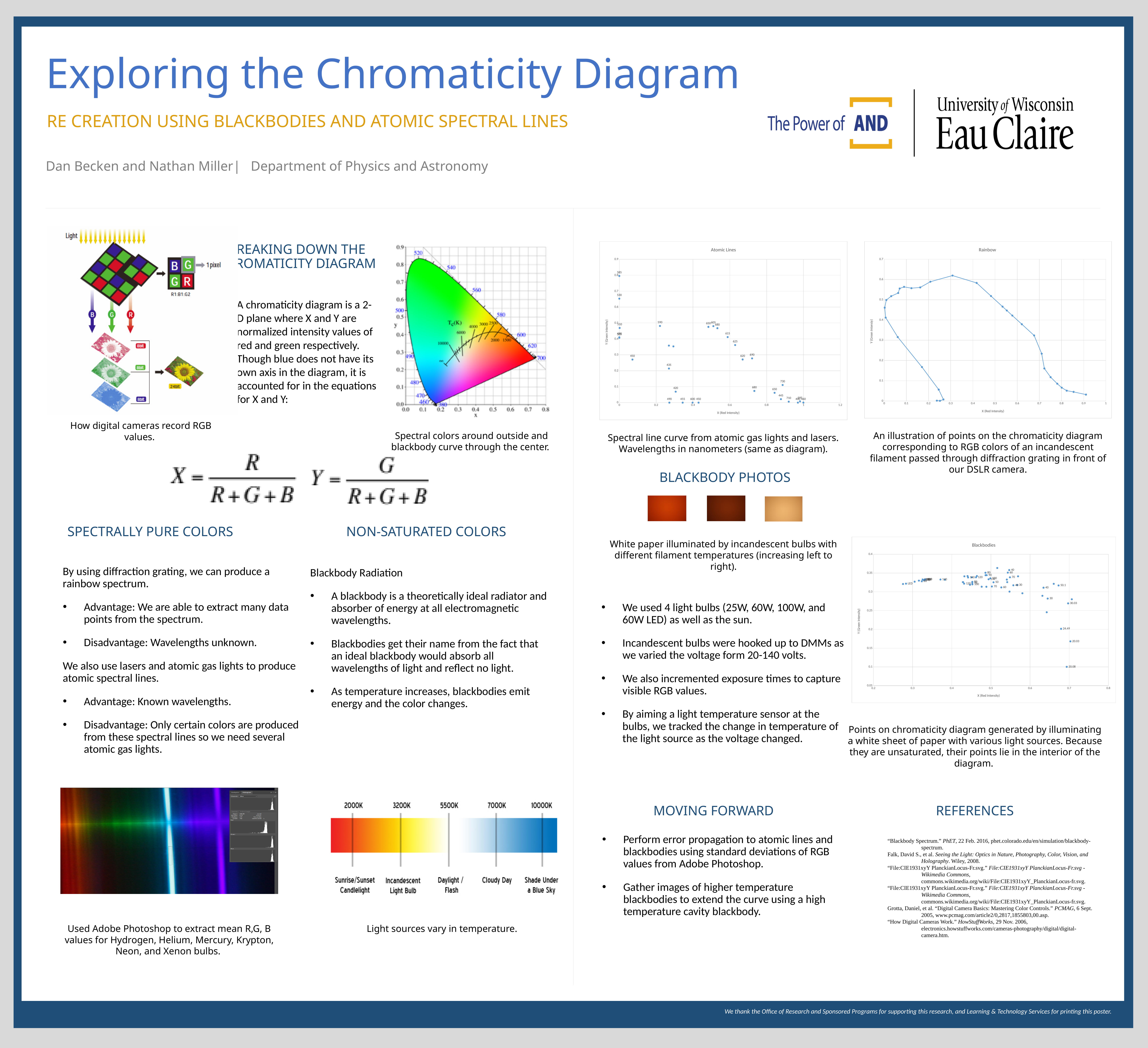
In the Atomic Lines chart, what is the label of the x axis? X (Red Intensity) What is the title of the scatter chart located to the left of the Rainbow chart? Atomic Lines In the Atomic Lines chart, is the X (Red Intensity) value of the point labeled 730 greater or less than 0.6? greater In the Blackbodies chart, is the Y (Green Intensity) value of the point labeled 20.08 greater or less than 0.2? less In the Blackbodies chart, is the X (Red Intensity) value of the point labeled 20.08 greater or less than 0.5? greater What kind of chart is the Blackbodies chart? scatter chart What is the title of the chart in the top-right corner of the poster? Rainbow In the Atomic Lines chart, which point has a higher Y (Green Intensity) value, the one labeled 585 or the one labeled 435? 585 What kind of chart is the Atomic Lines chart? scatter chart